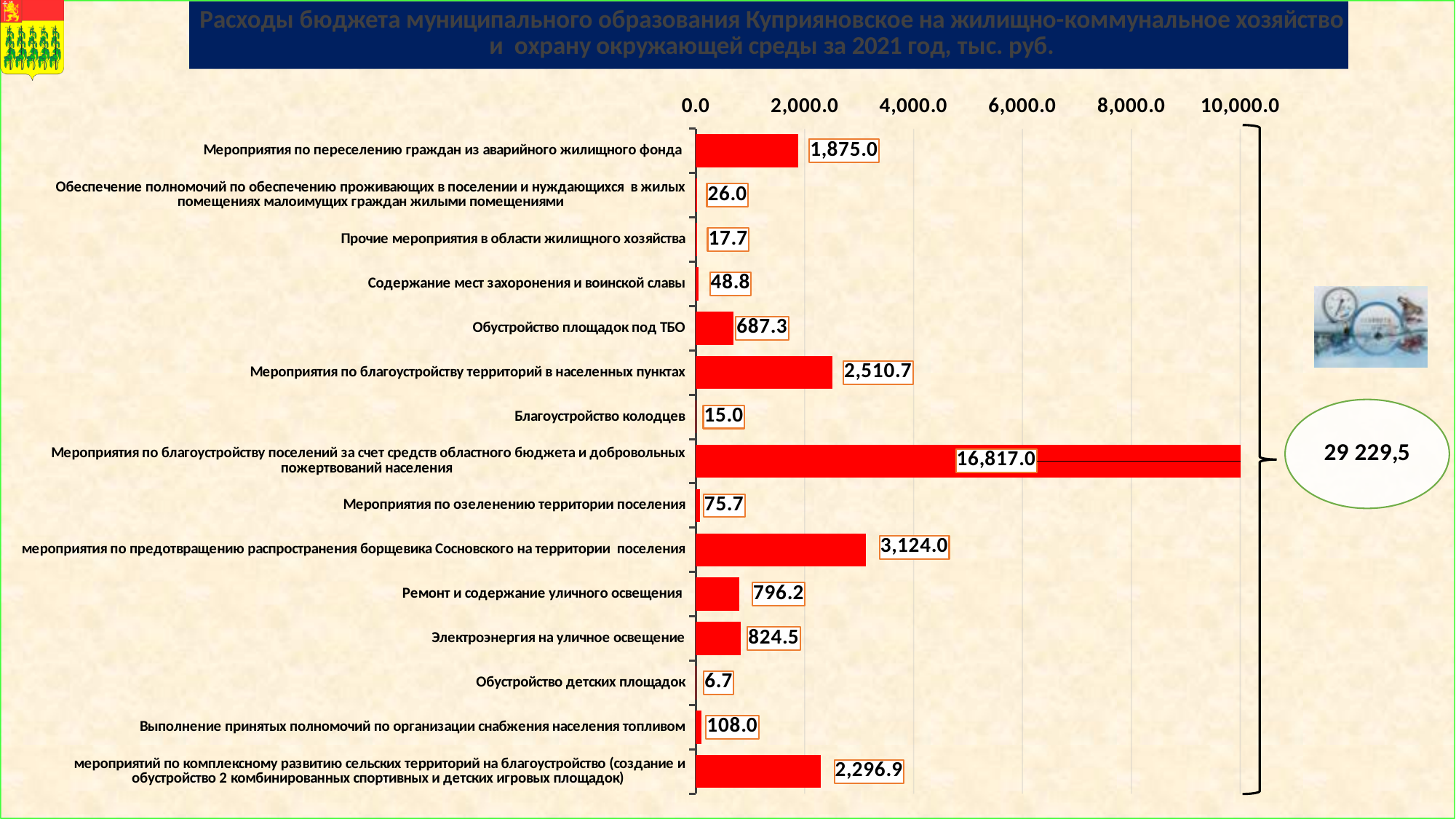
What total value is shown in the oval to the right of the chart? 29 229,5 What is the value for "Обустройство площадок под ТБО"? 687.3 Which is larger: "Мероприятия по благоустройству территорий в населенных пунктах" or "мероприятий по комплексному развитию сельских территорий на благоустройство"? Мероприятия по благоустройству территорий в населенных пунктах What is the difference between "Электроэнергия на уличное освещение" and "Ремонт и содержание уличного освещения"? 28.3 What type of chart is shown on the slide? bar chart Which category has the highest value? Мероприятия по благоустройству поселений за счет средств областного бюджета и добровольных пожертвований населения What is the difference between "мероприятия по предотвращению распространения борщевика Сосновского на территории поселения" and "Мероприятия по благоустройству территорий в населенных пунктах"? 613.3 What is the value for "Электроэнергия на уличное освещение"? 824.5 Which category has the lowest value? Обустройство детских площадок What is the value for "Мероприятия по переселению граждан из аварийного жилищного фонда"? 1,875.0 How many categories are plotted in the chart? 15 What is the value for "мероприятия по предотвращению распространения борщевика Сосновского на территории поселения"? 3,124.0